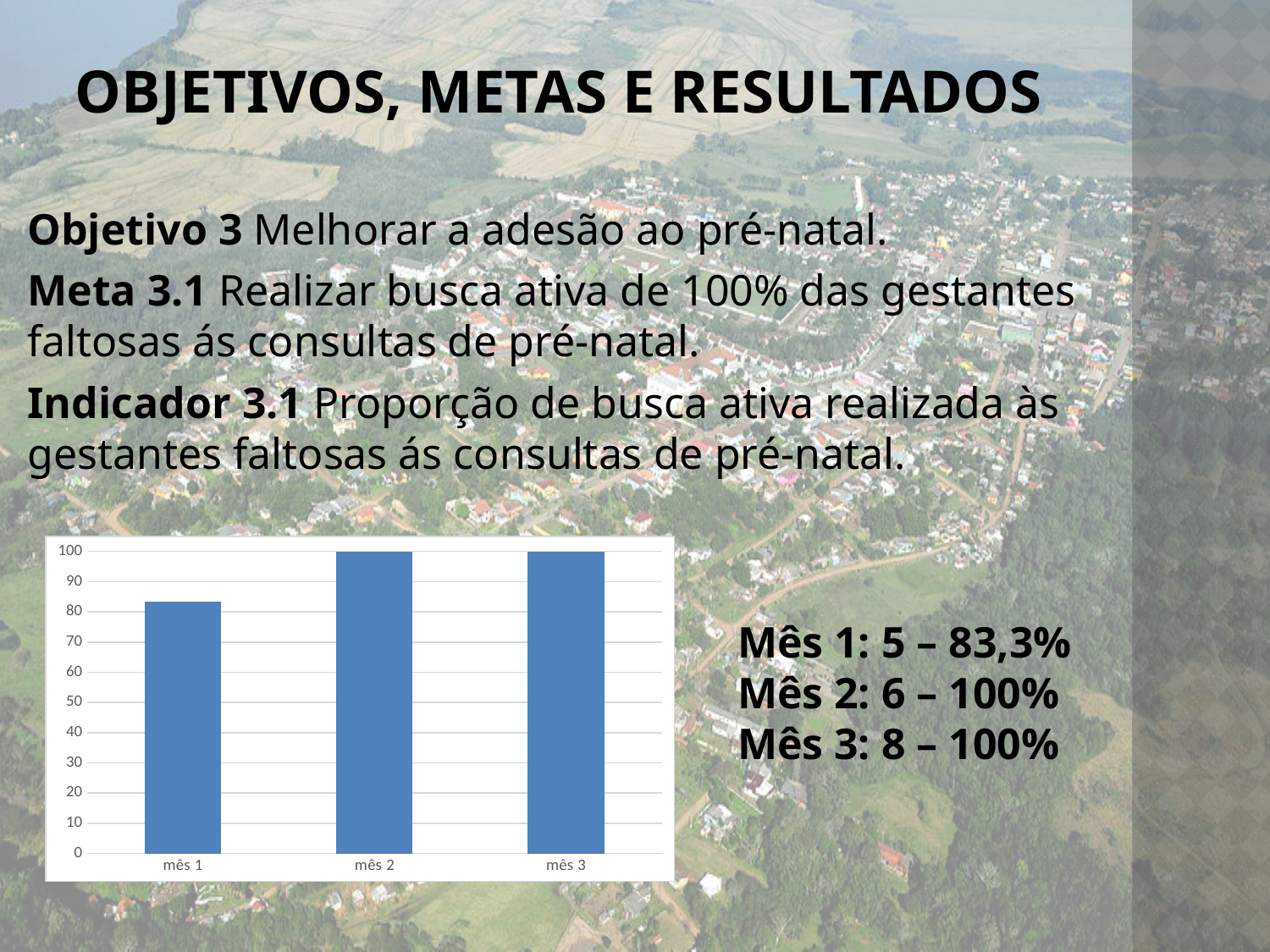
How many categories are shown on the x axis of the chart? 3 Is the value for mês 1 greater or less than 90? less What is the value of the bar for mês 2? 100 What is the value of the bar for mês 3? 100 What colour are the bars in the chart? blue Do the values rise or fall from mês 1 to mês 2? rise What is the difference between the values for mês 2 and mês 3? 0 Which is larger, the bar for mês 1 or the bar for mês 2? mês 2 Is the value for mês 1 greater or less than 80? greater What kind of chart is shown on the slide? bar chart Which category has the lowest bar in the chart? mês 1 What is the highest tick value shown on the vertical axis of the chart? 100